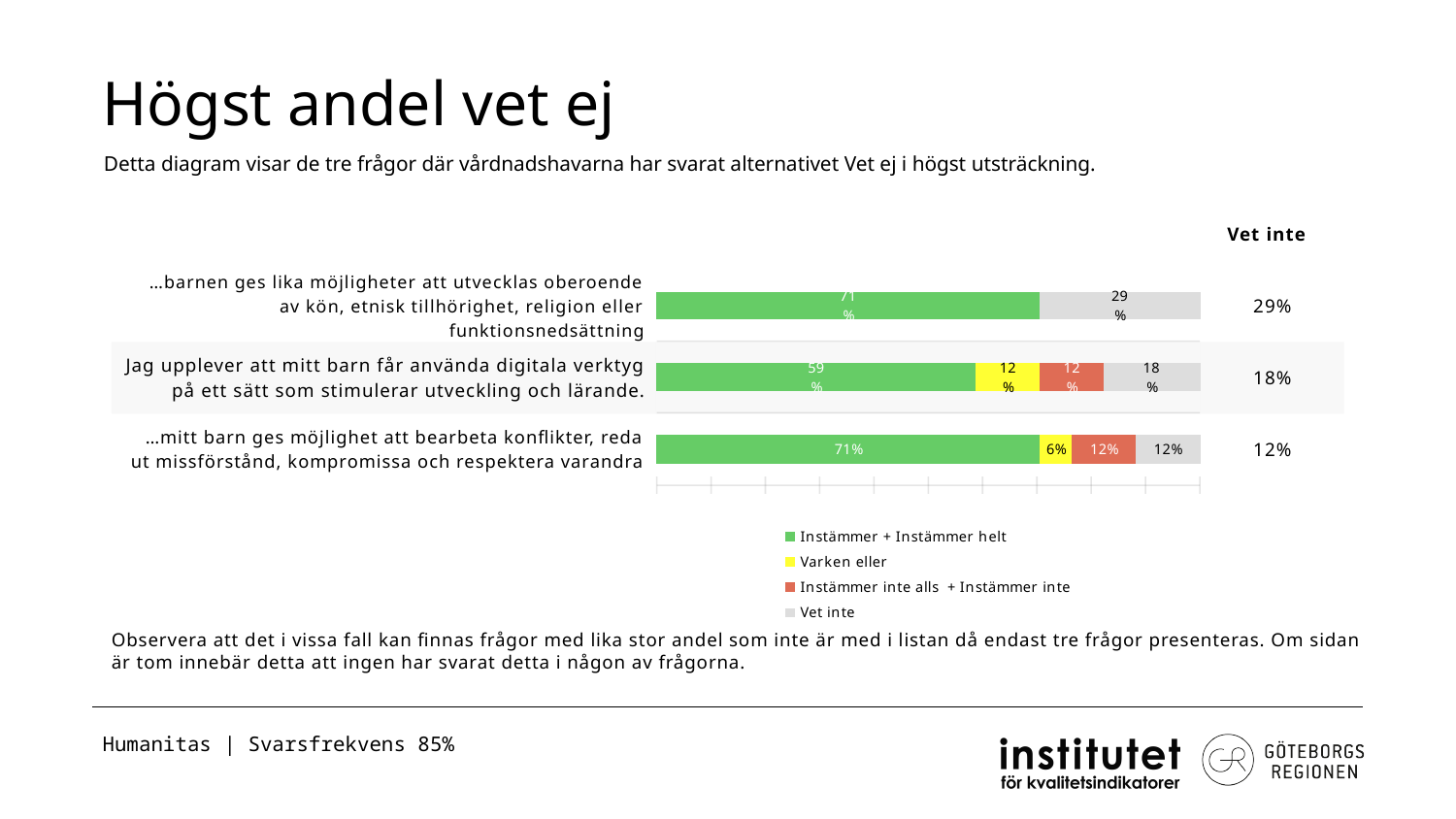
Is the 'Vet inte' share larger for 'Jag upplever att mitt barn får använda digitala verktyg…' or for '…mitt barn ges möjlighet att bearbeta konflikter…'? Jag upplever att mitt barn får använda digitala verktyg… What kind of chart is shown on the slide? stacked bar chart How many categories (questions) are plotted in the chart? 3 How many series does the legend list? 4 What colour represents 'Vet inte' in the chart? grey What is the difference between the 'Vet inte' share for the first category (29%) and the third category (12%)? 17% What is the 'Instämmer + Instämmer helt' value for 'Jag upplever att mitt barn får använda digitala verktyg på ett sätt som stimulerar utveckling och lärande.'? 59% What is the 'Vet inte' value for 'Jag upplever att mitt barn får använda digitala verktyg på ett sätt som stimulerar utveckling och lärande.'? 18% What is the 'Vet inte' share for '…barnen ges lika möjligheter att utvecklas oberoende av kön, etnisk tillhörighet, religion eller funktionsnedsättning'? 29% Which category has the lowest 'Instämmer + Instämmer helt' value? Jag upplever att mitt barn får använda digitala verktyg på ett sätt som stimulerar utveckling och lärande. What is the 'Varken eller' value for '…mitt barn ges möjlighet att bearbeta konflikter, reda ut missförstånd, kompromissa och respektera varandra'? 6% Which category has the highest 'Vet inte' share? …barnen ges lika möjligheter att utvecklas oberoende av kön, etnisk tillhörighet, religion eller funktionsnedsättning